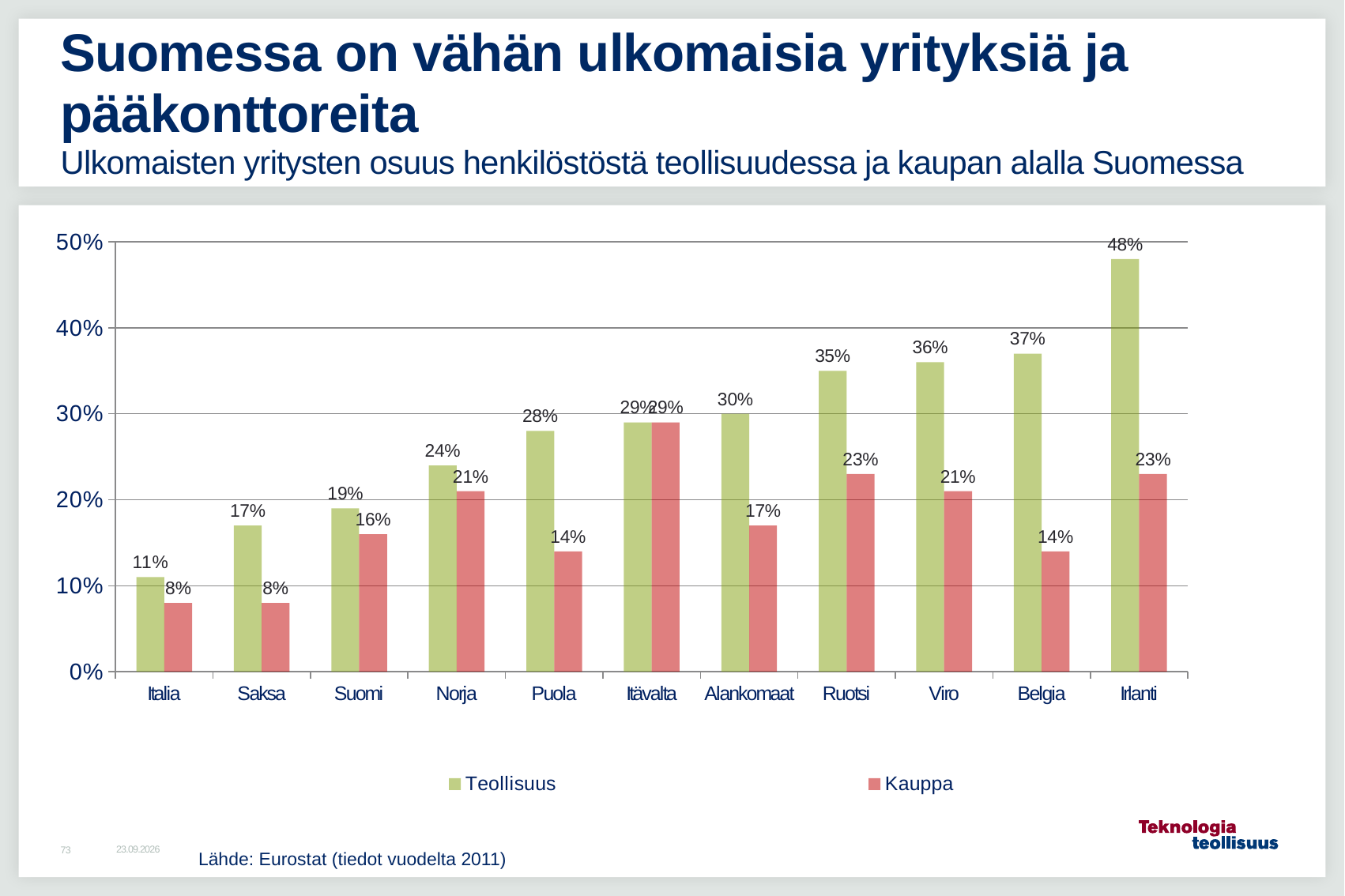
How many series does the legend list? 2 What is the difference between the Teollisuus and Kauppa values for Irlanti? 25% Is the Teollisuus value for Belgia greater or less than 30%? greater What is the Kauppa value for Ruotsi? 23% Do the Teollisuus values rise or fall from Italia to Irlanti along the x axis? rise What kind of chart is shown on the slide? bar chart Which country has the lowest Teollisuus value? Italia Which country has the highest Teollisuus value? Irlanti How many countries are shown on the x axis? 11 What is the source cited below the chart? Eurostat (tiedot vuodelta 2011) What is the Teollisuus value for Suomi? 19% Which is larger for Norja, the Teollisuus value or the Kauppa value? Teollisuus